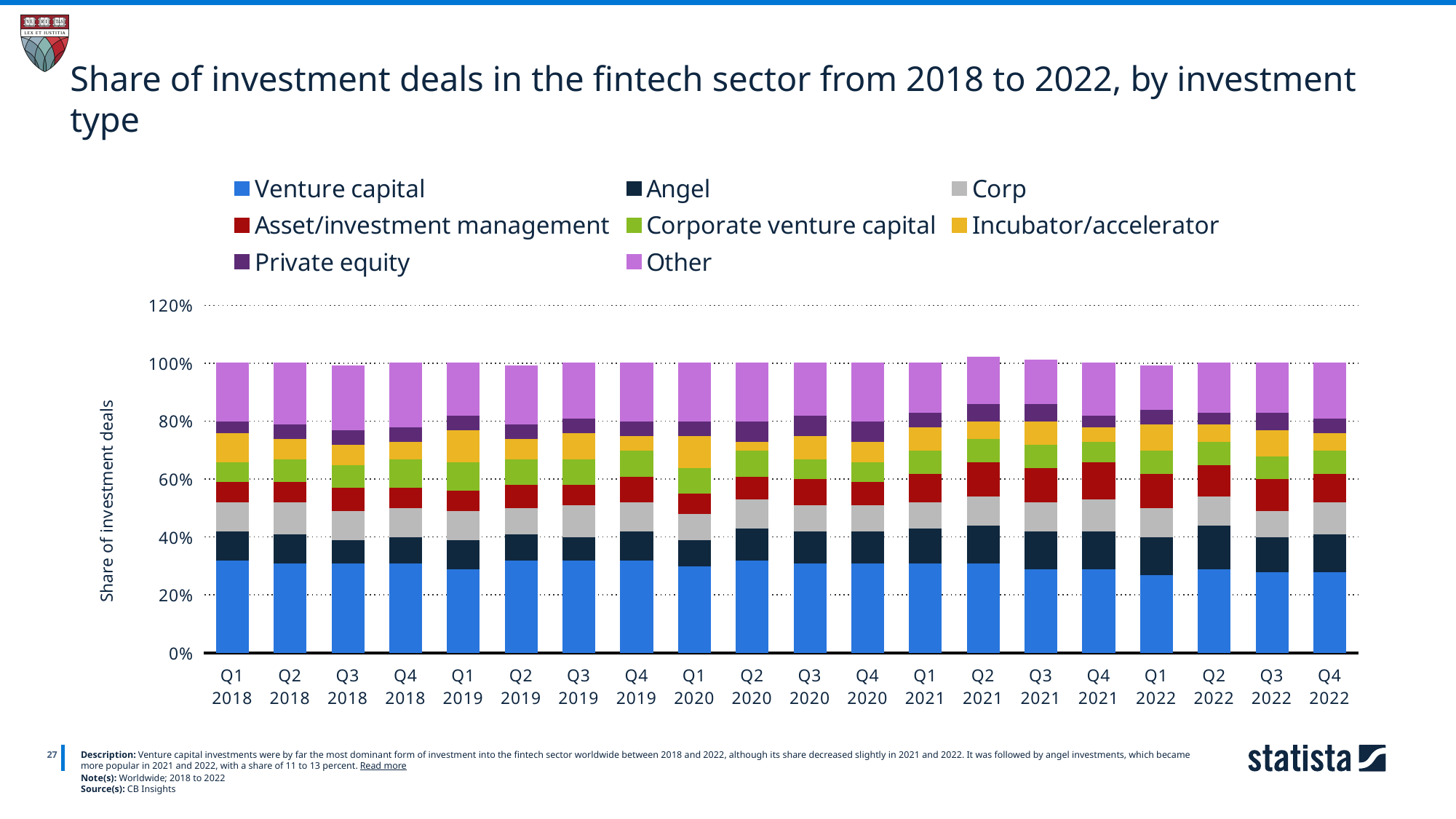
Is the cumulative share up to the top of the Angel segment in Q1 2018 greater or less than 60%? less How many series does the legend list? 8 Which is larger, the Venture capital share in Q1 2018 or in Q1 2022? Q1 2018 What kind of chart is shown on the slide? Stacked bar chart What is the title of the chart? Share of investment deals in the fintech sector from 2018 to 2022, by investment type Is the Venture capital share for Q1 2018 greater or less than 20%? greater Is the Venture capital share for Q1 2018 greater or less than 40%? less What is the label on the y axis? Share of investment deals Does the Venture capital share rise or fall from Q1 2018 to Q4 2022? fall How many quarters (categories) are plotted along the x axis? 20